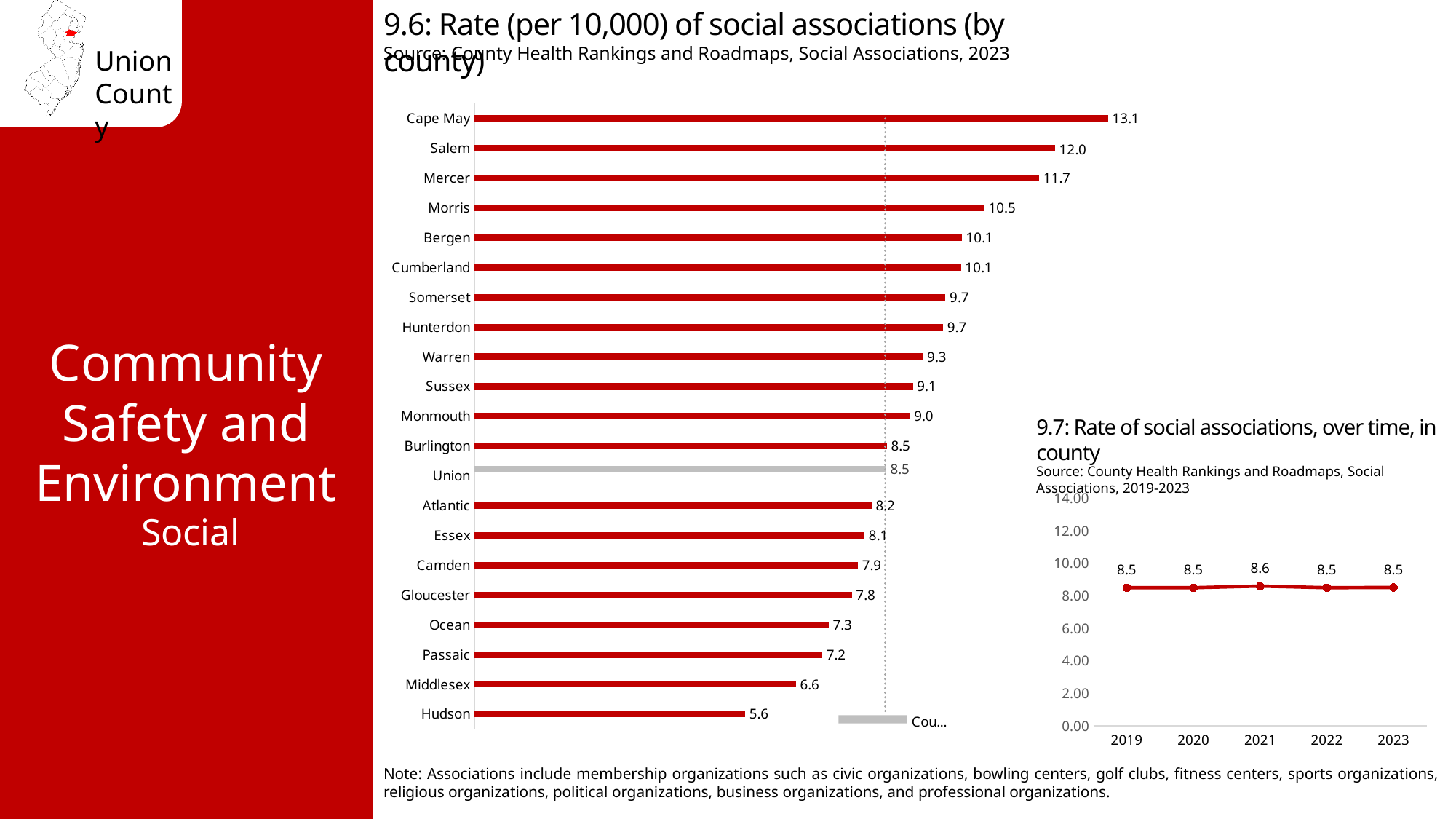
In chart 9.6 (rate of social associations by county), which county has the lowest rate? Hudson In chart 9.6 (rate of social associations by county), what is the value for Cape May? 13.1 In chart 9.6 (rate of social associations by county), which county's bar is shown in grey instead of red? Union In chart 9.6 (rate of social associations by county), what is the difference between the values for Salem and Hudson? 6.4 In chart 9.6 (rate of social associations by county), which has a higher rate, Morris or Middlesex? Morris In chart 9.7 (rate of social associations over time), how many years are plotted? 5 In chart 9.6 (rate of social associations by county), which county has the highest rate? Cape May In chart 9.6 (rate of social associations by county), what is the value for Union? 8.5 In chart 9.6 (rate of social associations by county), how many counties are shown? 21 What kind of chart is chart 9.6 (rate of social associations by county)? Bar chart What kind of chart is chart 9.7 (rate of social associations over time)? Line chart In chart 9.7 (rate of social associations over time), what is the value for 2021? 8.6